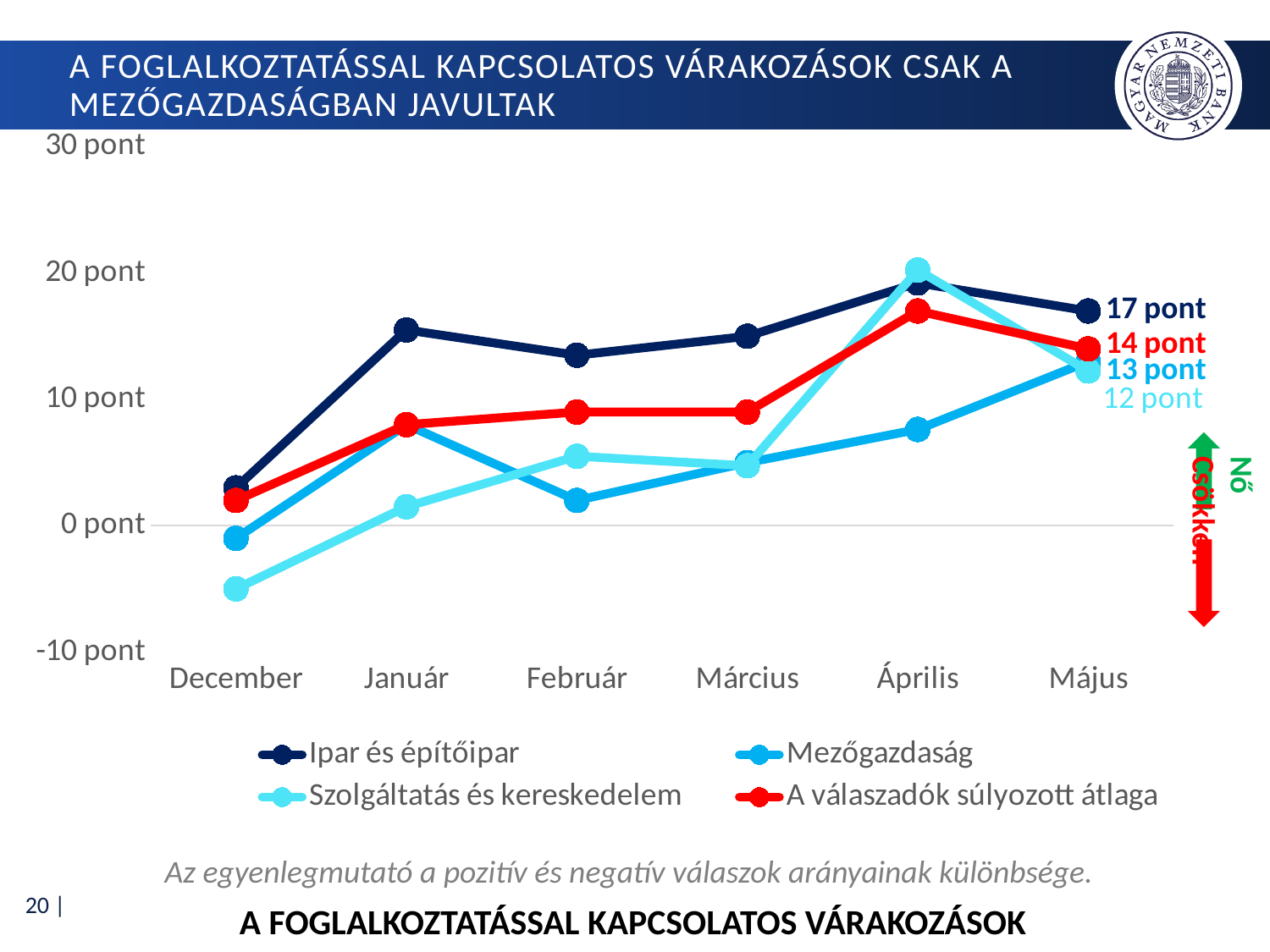
What is the value for Ipar és építőipar in Május? 17 pont What is the value for Szolgáltatás és kereskedelem in Május? 12 pont How many months are shown on the x axis? 6 What is the difference between Ipar és építőipar and Szolgáltatás és kereskedelem in Május? 5 pont Is the value for Szolgáltatás és kereskedelem in December greater or less than 0 pont? less How many series does the legend list? 4 Which series has the lowest value in December? Szolgáltatás és kereskedelem Does the Ipar és építőipar line rise or fall from December to Január? rise What is the value for Mezőgazdaság in Május? 13 pont In Május, which is larger: Ipar és építőipar or Mezőgazdaság? Ipar és építőipar What is the value for A válaszadók súlyozott átlaga in Május? 14 pont What kind of chart is shown on the slide? line chart